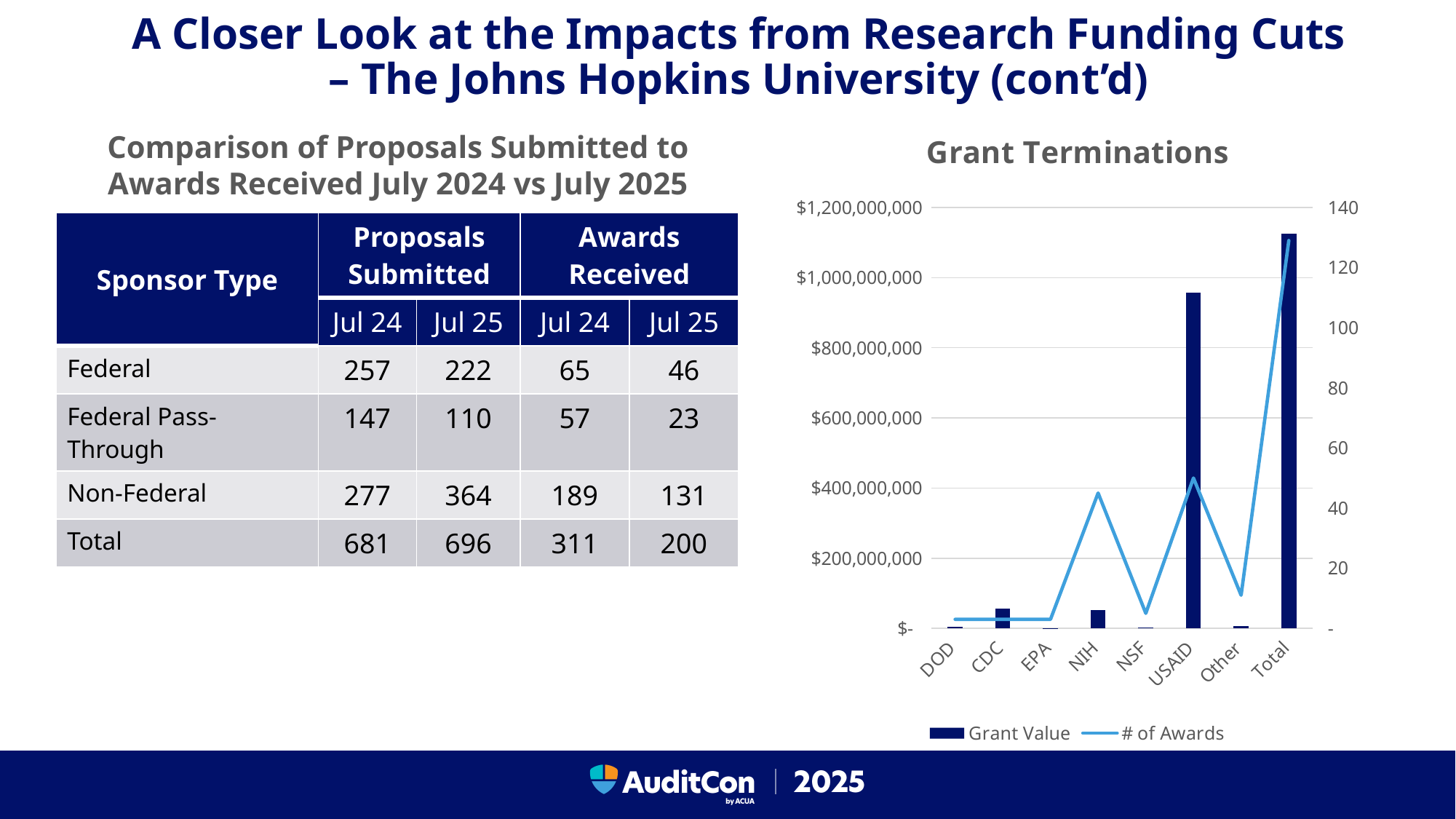
In the Grant Terminations chart, which has the larger Grant Value, USAID or NIH? USAID How many categories are shown on the x axis of the Grant Terminations chart? 8 What kind of chart is the Grant Terminations chart? A combined bar and line chart In the Grant Terminations chart, is the Grant Value for USAID greater or less than $1,000,000,000? less What are the two legend entries in the Grant Terminations chart? Grant Value and # of Awards In the Grant Terminations chart, is the # of Awards for Other greater or less than 20? less In the Grant Terminations chart, is the # of Awards for NIH greater or less than 20? greater In the Grant Terminations chart, which agency (excluding Total) has the highest Grant Value? USAID In the Grant Terminations chart, which has the larger # of Awards, NIH or NSF? NIH How many series does the legend of the Grant Terminations chart list? 2 In the Grant Terminations chart, which category has the highest Grant Value bar? Total